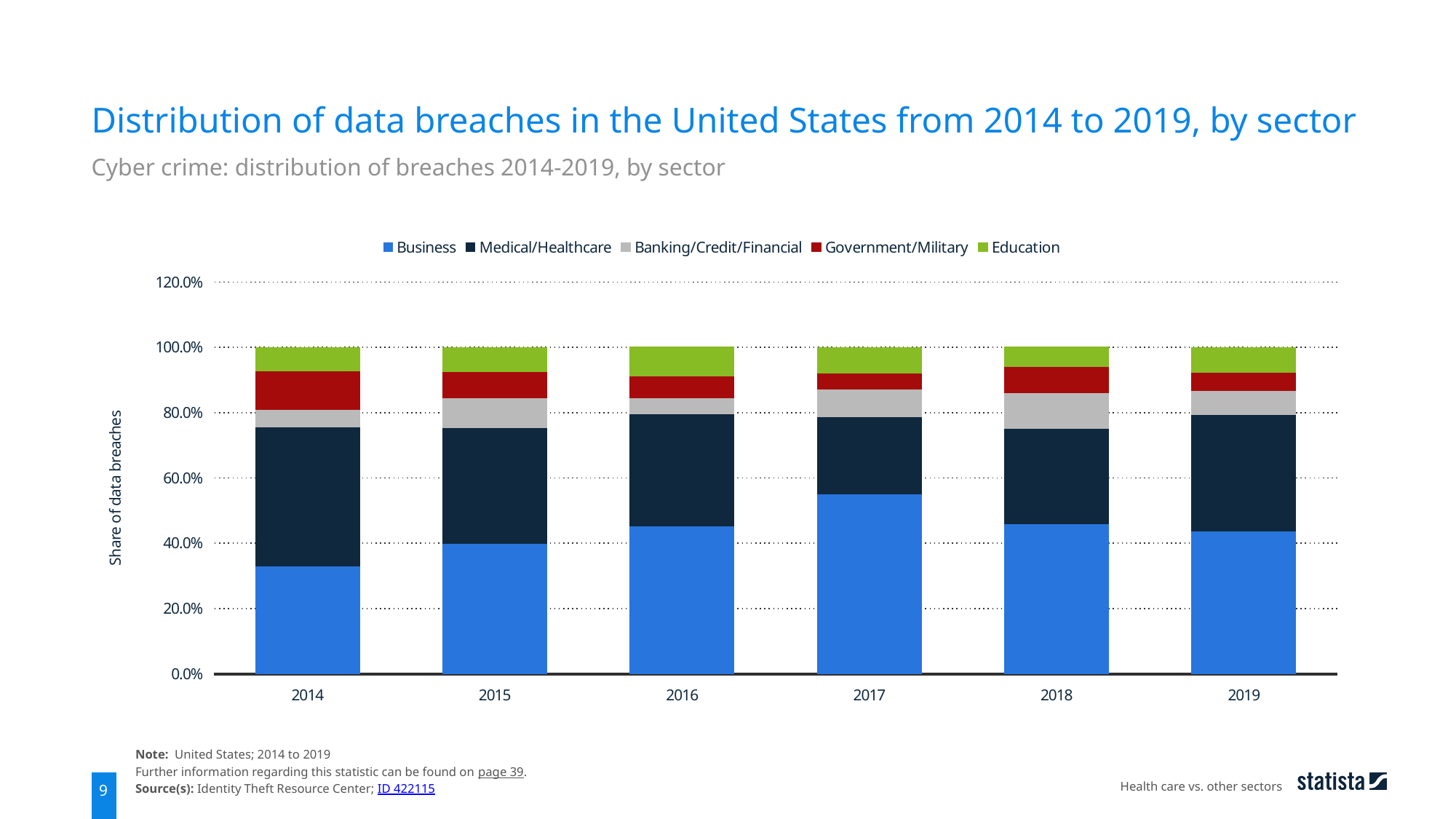
In which year is the Business share of data breaches the lowest? 2014 What kind of chart is shown on the slide? Stacked bar chart What is the total height of the stacked bar for 2014? 100.0% Is the Business share of data breaches in 2014 greater or less than 40.0%? less In which year is the Medical/Healthcare segment the smallest? 2017 In which year is the Business share of data breaches the highest? 2017 How many series does the legend list? 5 Does the Business share of data breaches rise or fall from 2014 to 2017? rise Is the Business share of data breaches in 2017 greater or less than 40.0%? greater How many years are shown on the x axis of the chart? 6 Which is larger, the Business share in 2017 or the Business share in 2014? 2017 What is the label on the y axis of the chart? Share of data breaches